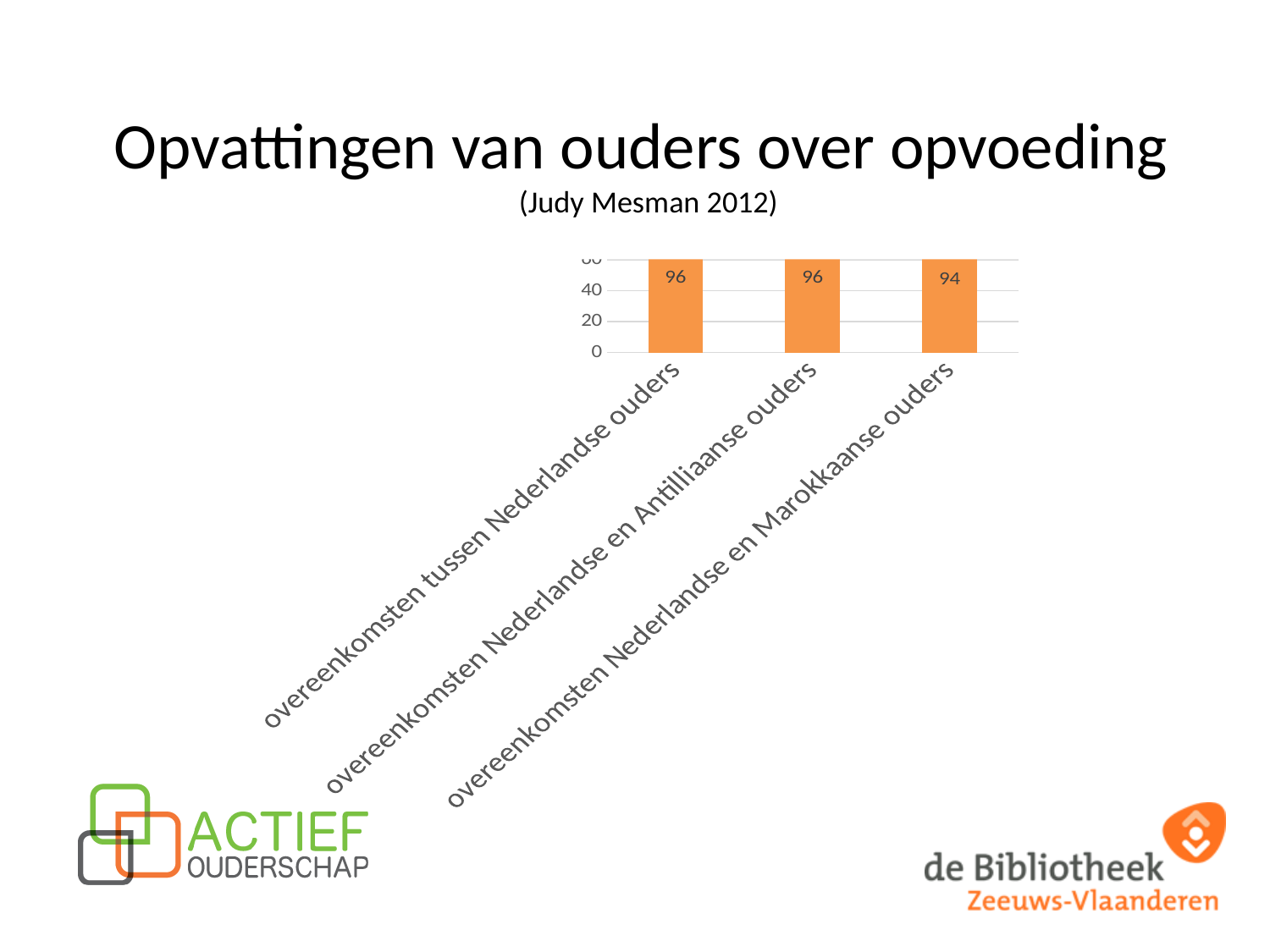
What is the difference between the value for 'overeenkomsten tussen Nederlandse ouders' and the value for 'overeenkomsten Nederlandse en Marokkaanse ouders'? 2 What is the value for 'overeenkomsten tussen Nederlandse ouders'? 96 How many categories are shown in the chart? 3 Is the value for 'overeenkomsten Nederlandse en Marokkaanse ouders' greater or less than 40? greater What is the title of the slide containing the chart? Opvattingen van ouders over opvoeding Which is larger: the value for 'overeenkomsten Nederlandse en Antilliaanse ouders' or the value for 'overeenkomsten Nederlandse en Marokkaanse ouders'? overeenkomsten Nederlandse en Antilliaanse ouders What is the value for 'overeenkomsten Nederlandse en Antilliaanse ouders'? 96 What is the value for 'overeenkomsten Nederlandse en Marokkaanse ouders'? 94 Which category has the lowest value? overeenkomsten Nederlandse en Marokkaanse ouders What colour are the bars in the chart? orange Do the values rise or fall from the first category to the last category along the x axis? fall What kind of chart is shown on the slide? bar chart